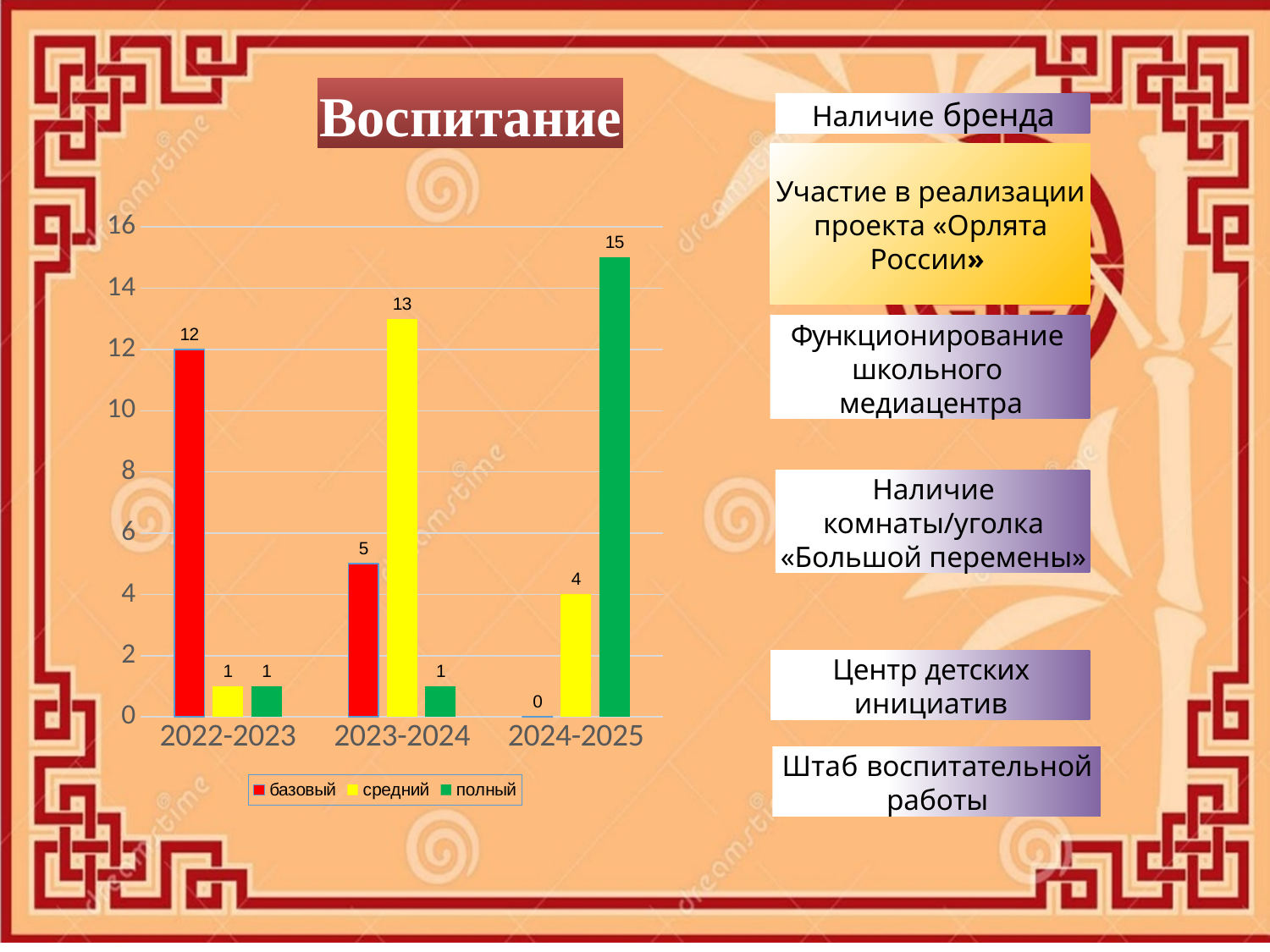
Does the полный series rise or fall from 2022-2023 to 2024-2025? rise Which is larger in 2023-2024: базовый or средний? средний What kind of chart is shown on the slide? bar chart How many series does the legend list? 3 What is the value for базовый in 2022-2023? 12 What is the difference between средний in 2023-2024 and средний in 2024-2025? 9 In which year is the базовый series lowest? 2024-2025 What is the value for полный in 2024-2025? 15 What is the value for базовый in 2024-2025? 0 How many year categories are shown on the x axis? 3 In which year is the полный series highest? 2024-2025 What is the value for средний in 2023-2024? 13